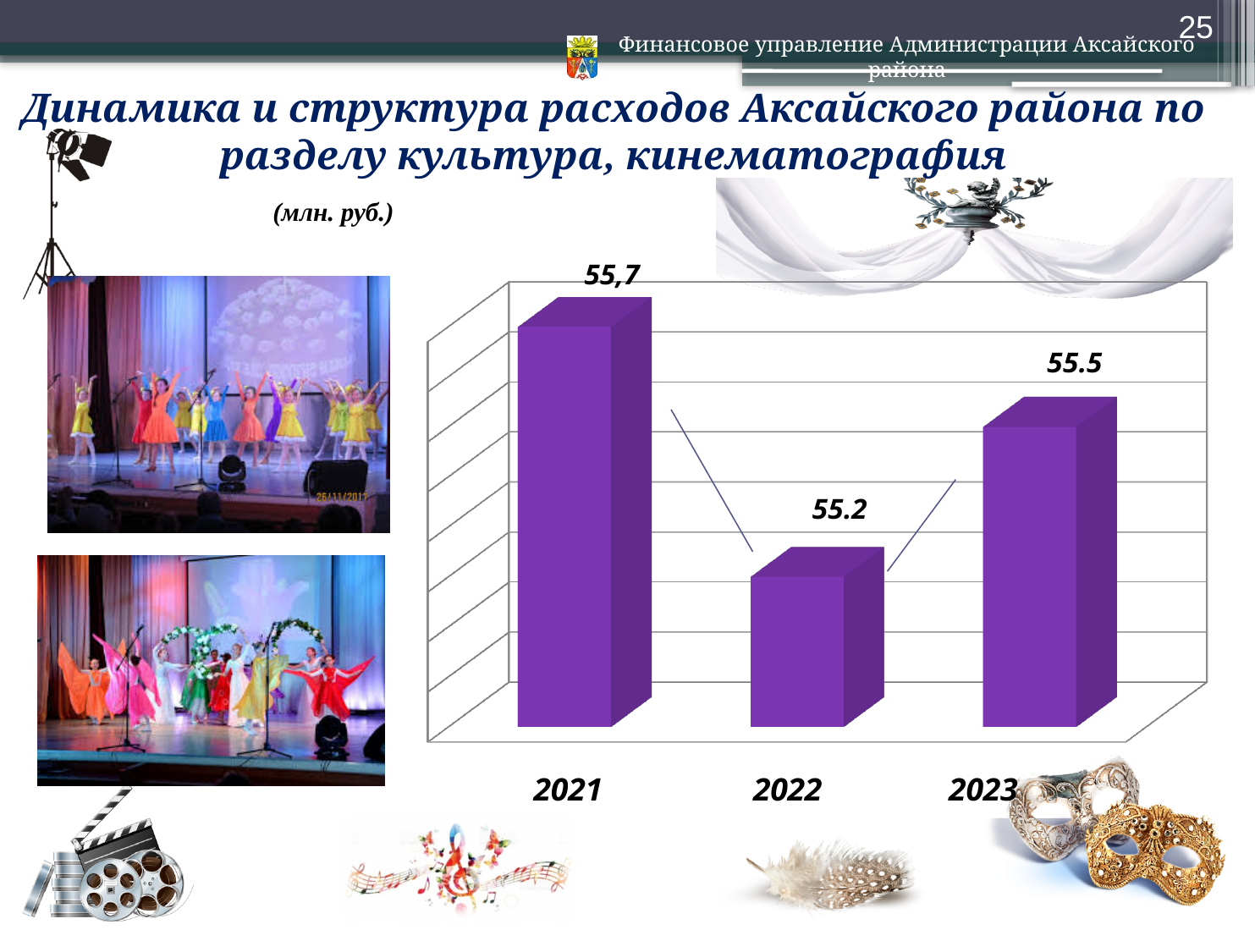
How does the value change from 2021 to 2022? It falls What is the value for 2022? 55.2 Which year has the lowest value? 2022 In what units are the chart values given? млн. руб. What is the value for 2023? 55.5 What is the value for 2021? 55,7 What kind of chart is shown on the slide? bar chart Which year has the highest value? 2021 How many years are shown on the chart? 3 Which is larger, the value for 2021 or the value for 2023? 2021 What is the difference between the values for 2023 and 2022? 0.3 What is the difference between the values for 2021 and 2022? 0.5